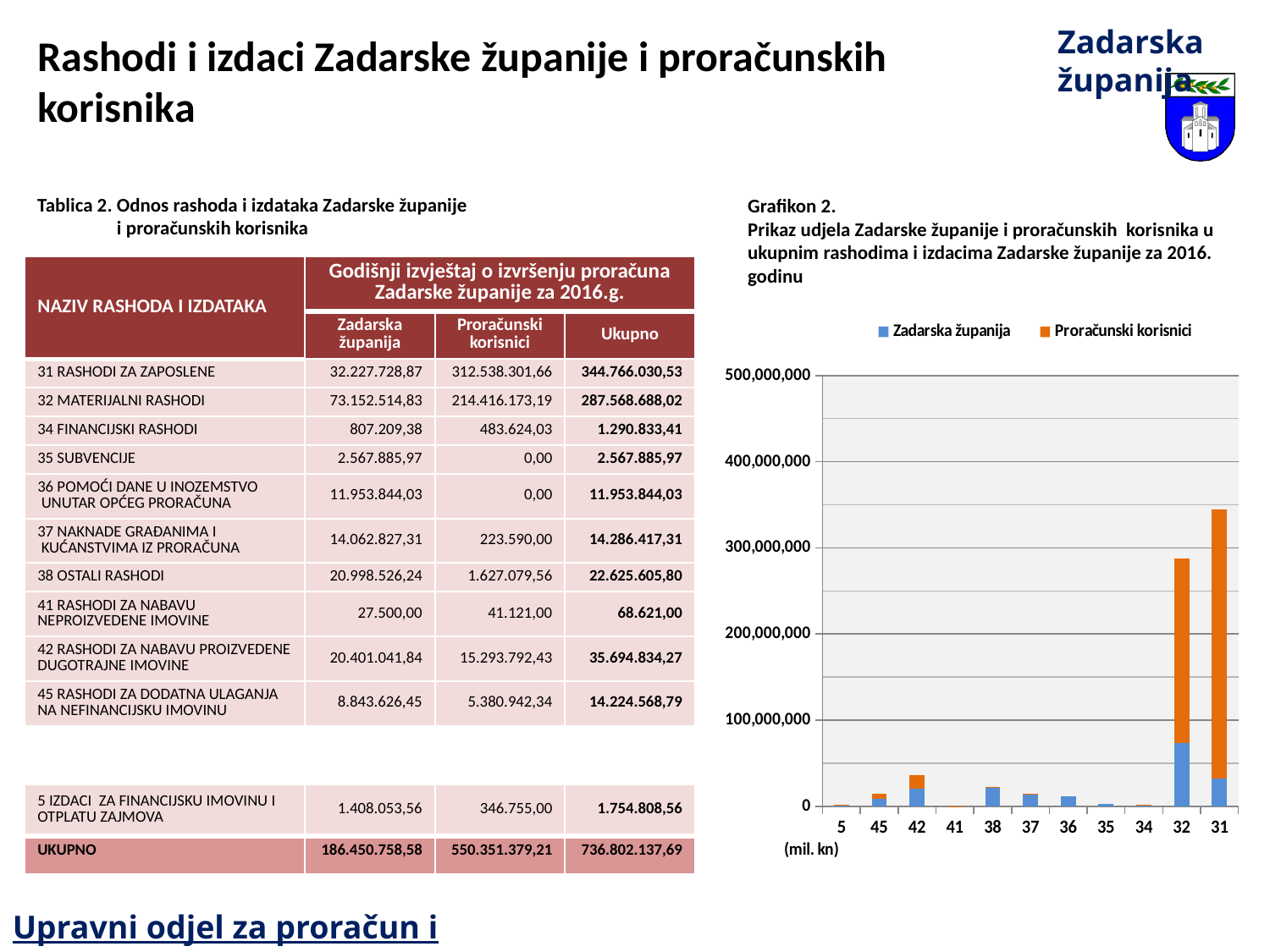
In Grafikon 2, is the total stacked bar for category 32 greater or less than 200,000,000? greater How many categories are shown on the x axis of Grafikon 2? 11 In Grafikon 2, is the total stacked bar for category 31 greater or less than 300,000,000? greater In Grafikon 2, is the total stacked bar for category 32 greater or less than 300,000,000? less How many series does the legend of Grafikon 2 list? 2 In Grafikon 2, which stacked bar is taller, category 42 or category 38? 42 In Grafikon 2, which stacked bar is taller, category 31 or category 32? 31 What kind of chart is Grafikon 2? bar chart Which category has the tallest stacked bar in Grafikon 2? 31 Which series in Grafikon 2 is shown in orange? Proračunski korisnici